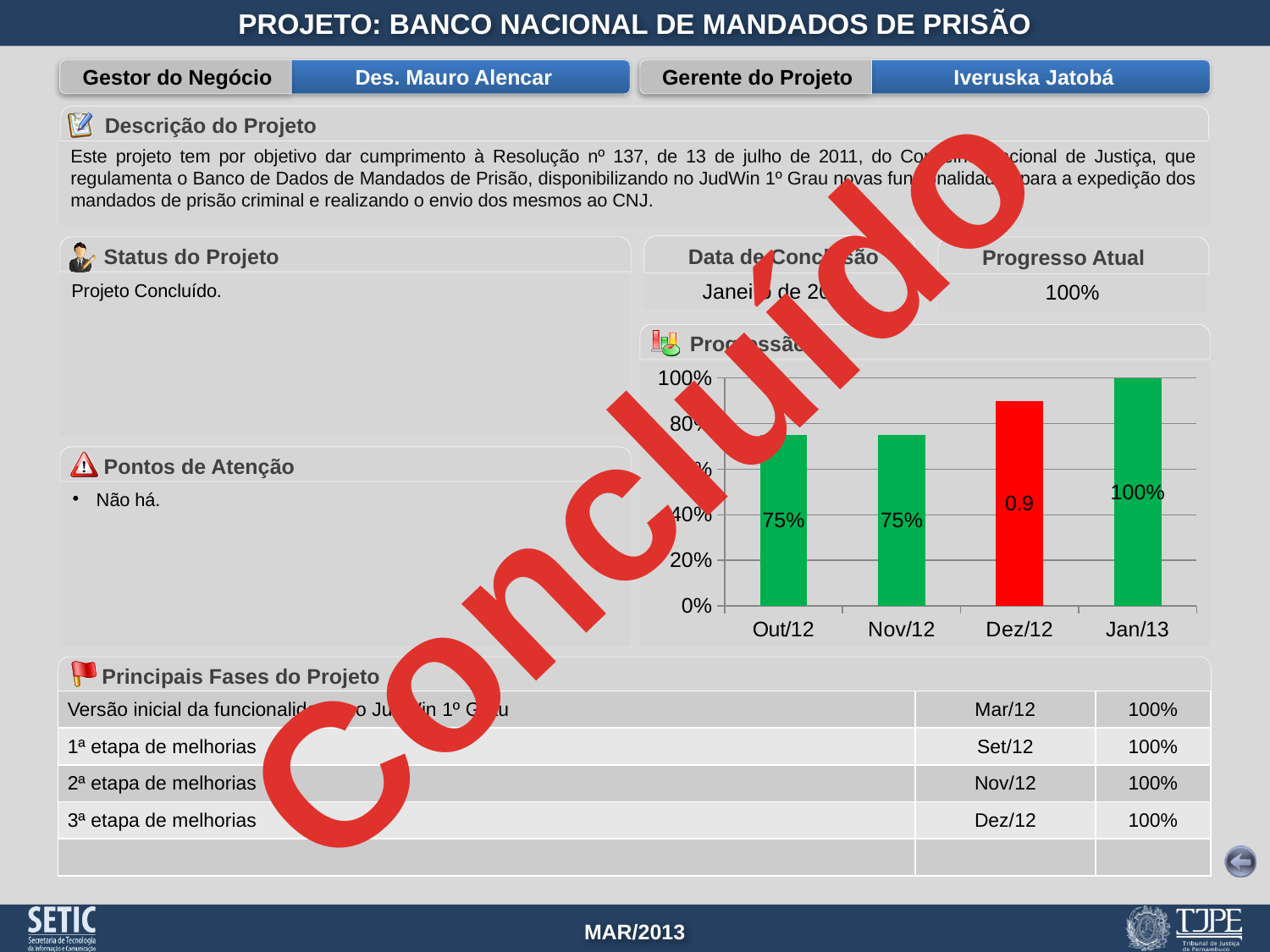
Which is larger, the bar for Dez/12 or the bar for Nov/12? Dez/12 Which month's bar is coloured red in the chart? Dez/12 What kind of chart is shown on the slide? bar chart What is the value shown for Out/12 in the bar chart? 75% Which month has the highest bar in the chart? Jan/13 What data label is printed on the Dez/12 bar? 0.9 How many months are shown on the x axis of the chart? 4 Do the values rise or fall from Out/12 to Jan/13? rise Is the value for Dez/12 greater or less than 80%? greater What is the value shown for Nov/12 in the bar chart? 75% What is the value shown for Jan/13 in the bar chart? 100% What is the difference between the values for Jan/13 and Out/12? 25%